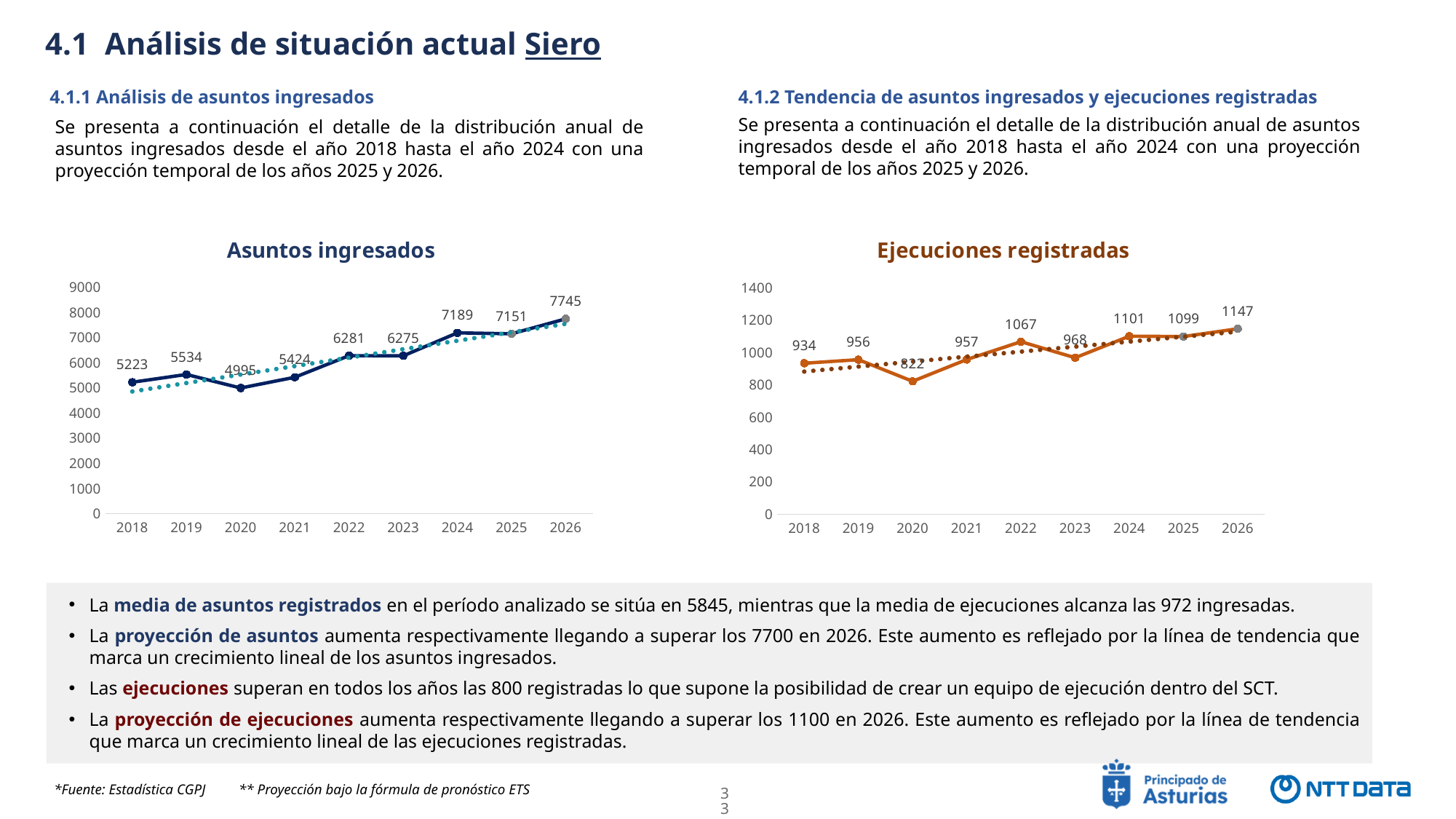
In the 'Asuntos ingresados' chart, which year has the lowest value? 2020 In the 'Ejecuciones registradas' chart, which year has the highest value? 2026 In the 'Ejecuciones registradas' chart, what is the value for 2022? 1067 In the 'Ejecuciones registradas' chart, what is the difference between the values for 2026 and 2020? 325 How many years are plotted on the x axis of the 'Asuntos ingresados' chart? 9 In the 'Asuntos ingresados' chart, what is the value for 2026? 7745 In the 'Asuntos ingresados' chart, what is the difference between the values for 2024 and 2018? 1966 In the 'Asuntos ingresados' chart, which year has the highest value? 2026 What kind of chart is the 'Ejecuciones registradas' chart? Line chart In the 'Ejecuciones registradas' chart, which is larger, the value for 2019 or the value for 2021? 2021 In the 'Ejecuciones registradas' chart, which year has the lowest value? 2020 In the 'Asuntos ingresados' chart, what is the value for 2018? 5223